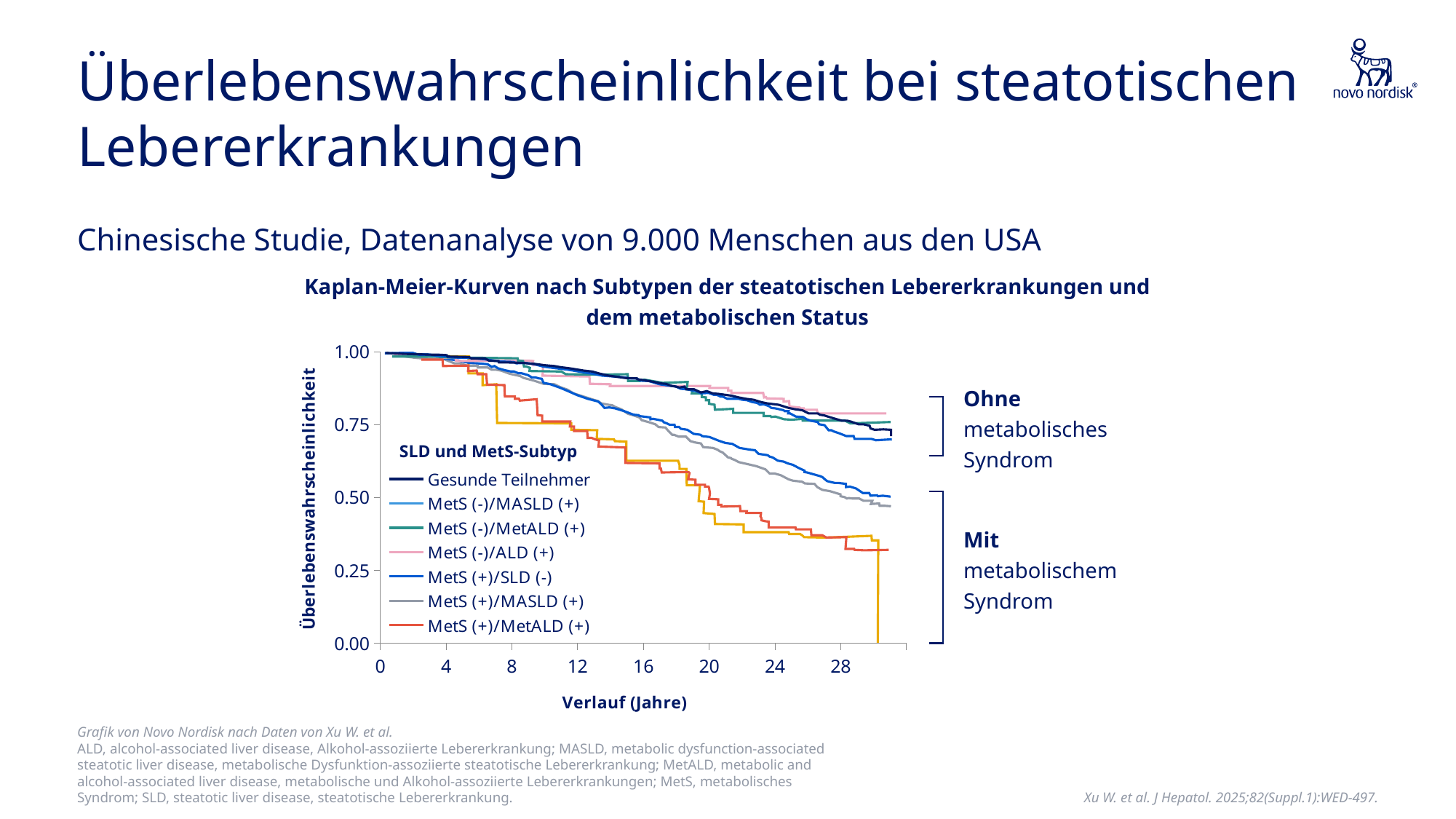
Is the value for Gesunde Teilnehmer at 16 years greater or less than 0.75? greater Do the survival curves rise or fall along the x axis (Verlauf in Jahren)? Fall Is the value for MetS (-)/ALD (+) at 28 years greater or less than 0.75? greater What is the label of the x axis of the chart? Verlauf (Jahre) Is the value for MetS (+)/MetALD (+) at 28 years greater or less than 0.50? less How many series does the chart legend list? 7 At 24 years, which is higher: Gesunde Teilnehmer or MetS (+)/MASLD (+)? Gesunde Teilnehmer What kind of chart is shown on the slide? Line chart What is the title of the chart legend? SLD und MetS-Subtyp At 28 years, which is higher: MetS (-)/ALD (+) or MetS (+)/MetALD (+)? MetS (-)/ALD (+)